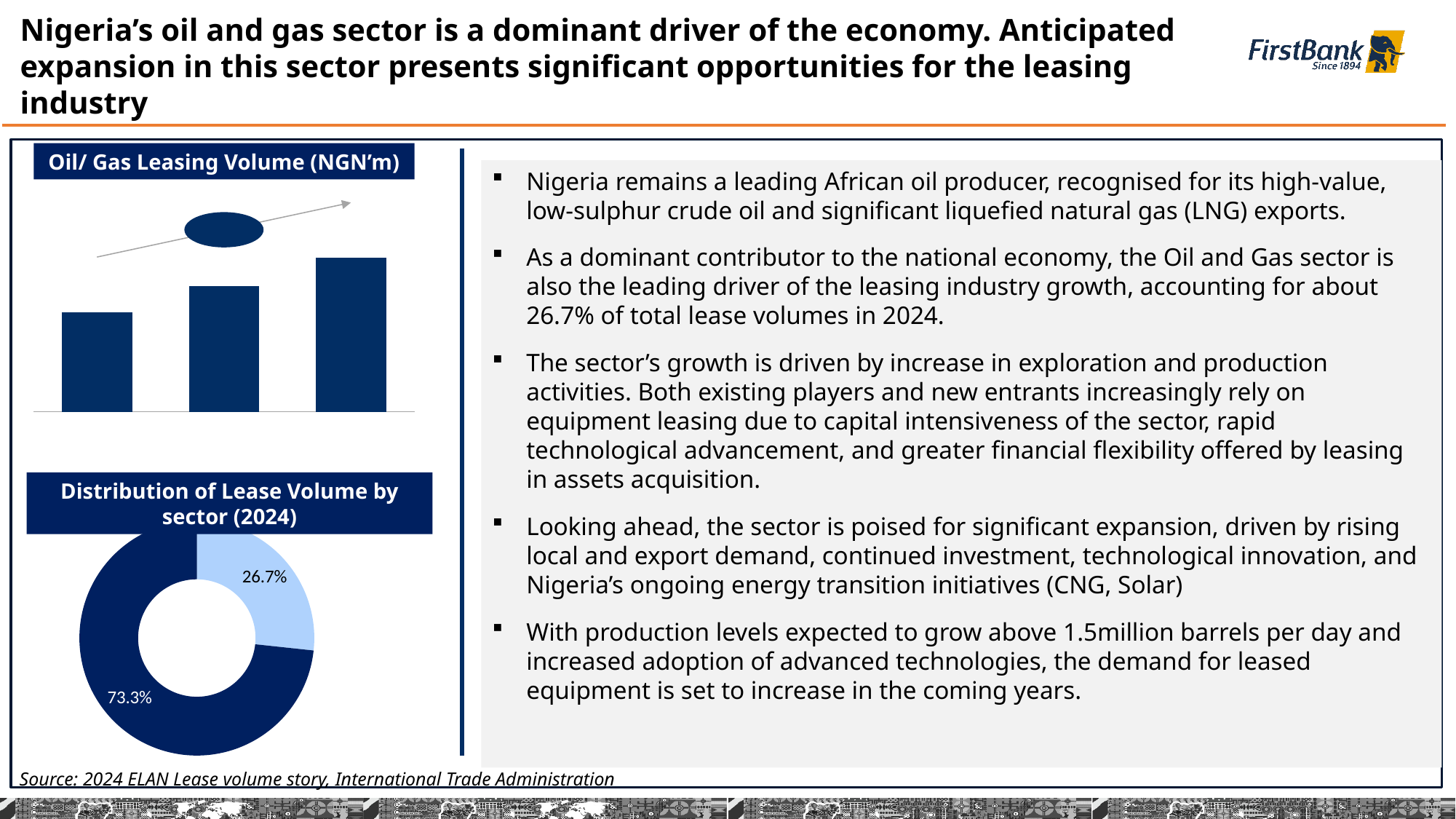
In the 'Oil/ Gas Leasing Volume (NGN'm)' chart, do the bars rise or fall from left to right? rise In the 'Distribution of Lease Volume by sector (2024)' chart, what is the difference in percentage points between the 73.3% slice and the 26.7% slice? 46.6 percentage points In the 'Oil/ Gas Leasing Volume (NGN'm)' chart, which bar is the tallest? the rightmost (third) bar In the 'Distribution of Lease Volume by sector (2024)' chart, what share is shown for the light blue slice? 26.7% What is the title of the bar chart on the slide? Oil/ Gas Leasing Volume (NGN'm) What kind of chart is the 'Oil/ Gas Leasing Volume (NGN'm)' chart? bar chart In the 'Distribution of Lease Volume by sector (2024)' chart, what share is shown for the dark blue slice? 73.3% How many bars are plotted in the 'Oil/ Gas Leasing Volume (NGN'm)' chart? 3 In the 'Distribution of Lease Volume by sector (2024)' chart, what is the largest slice's value? 73.3% In the 'Oil/ Gas Leasing Volume (NGN'm)' chart, which bar is the shortest? the leftmost (first) bar How many slices does the 'Distribution of Lease Volume by sector (2024)' chart have? 2 What kind of chart is the 'Distribution of Lease Volume by sector (2024)' chart? doughnut (pie) chart